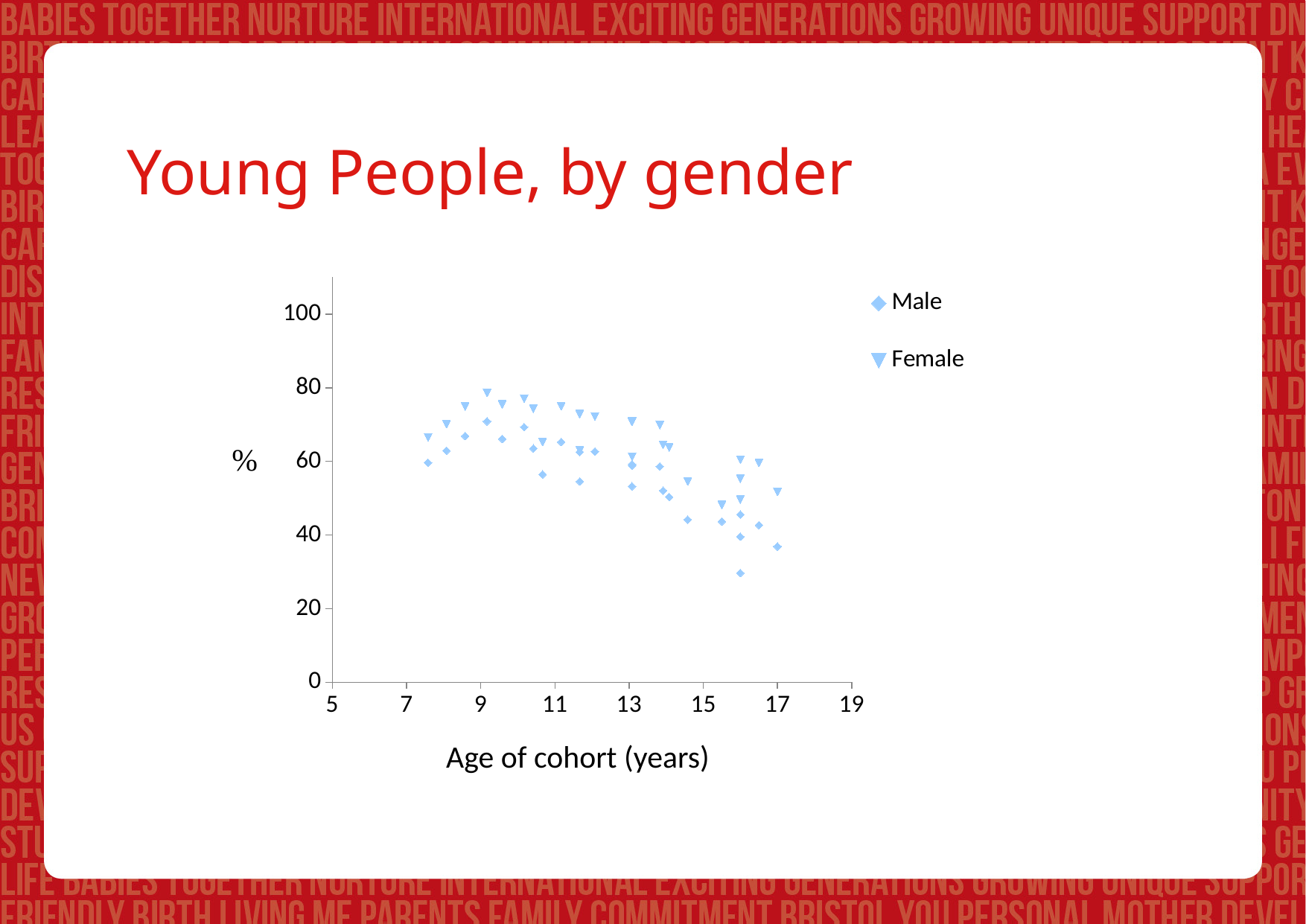
Is the lowest Male point on the chart greater or less than 40? less Is the highest Female point on the chart greater or less than 60? greater What is the highest value shown on the chart's y axis? 100 What kind of chart is shown on the slide? Scatter chart What is the title of the chart's x axis? Age of cohort (years) What are the two series named in the chart legend? Male and Female Is the highest Male point on the chart greater or less than 80? less Which series has the lowest plotted point on the chart, Male or Female? Male Do the plotted values generally rise or fall as the age of cohort increases? Fall How many series does the chart legend list? 2